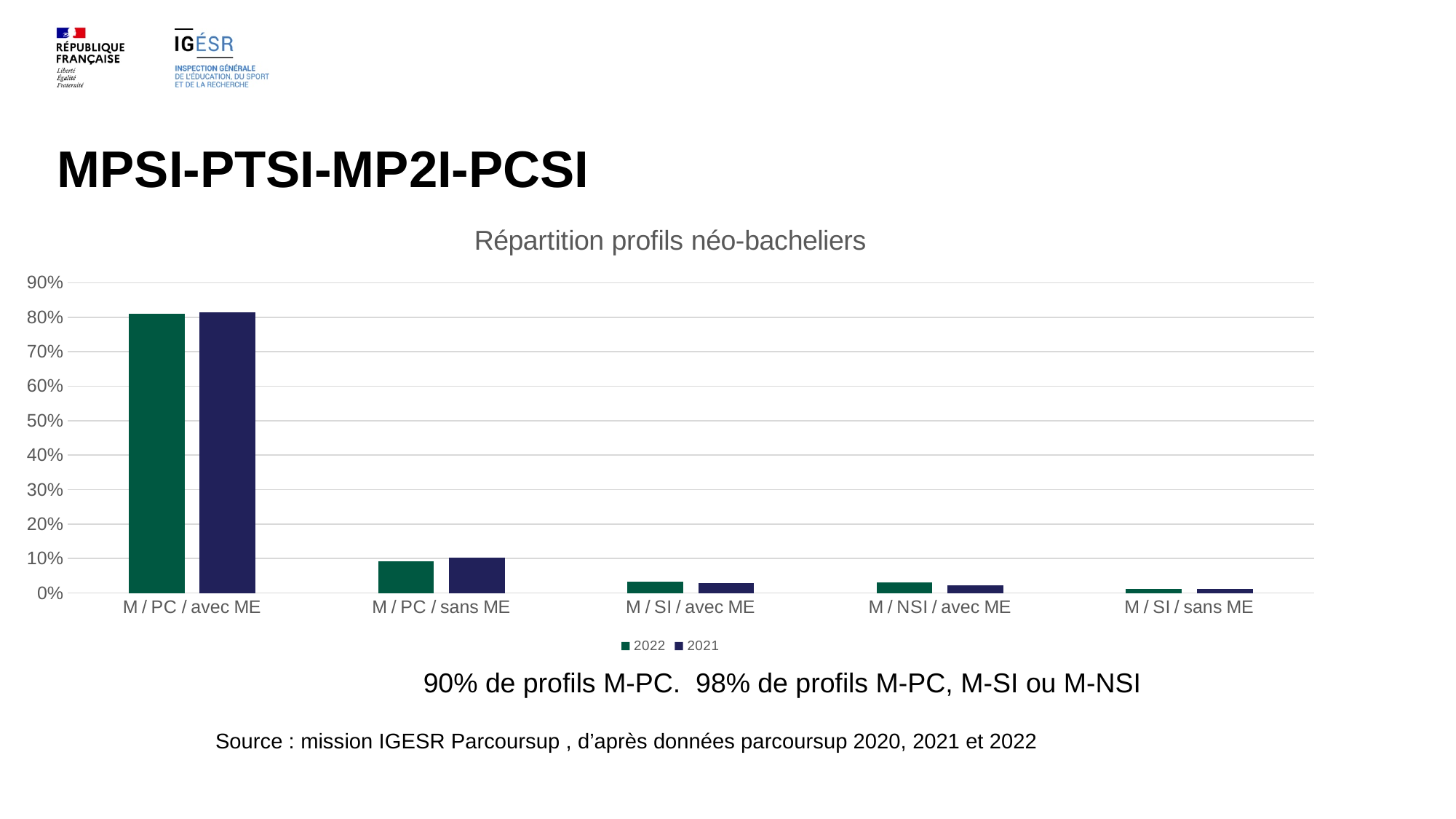
Is the 2022 value for M / SI / avec ME greater or less than 10%? less Do the values rise or fall from left to right along the x axis? fall Which series is shown in dark green in the chart? 2022 What is the title of the chart? Répartition profils néo-bacheliers Is the 2021 value for M / PC / sans ME greater or less than 20%? less How many series does the chart's legend list? 2 Which category has the highest value in the chart? M / PC / avec ME How many categories are shown on the x axis of the chart? 5 Which is larger for 2021: M / PC / avec ME or M / PC / sans ME? M / PC / avec ME What kind of chart is shown on the slide? bar chart Which category has the lowest value in the chart? M / SI / sans ME Is the 2022 value for M / PC / avec ME greater or less than 70%? greater